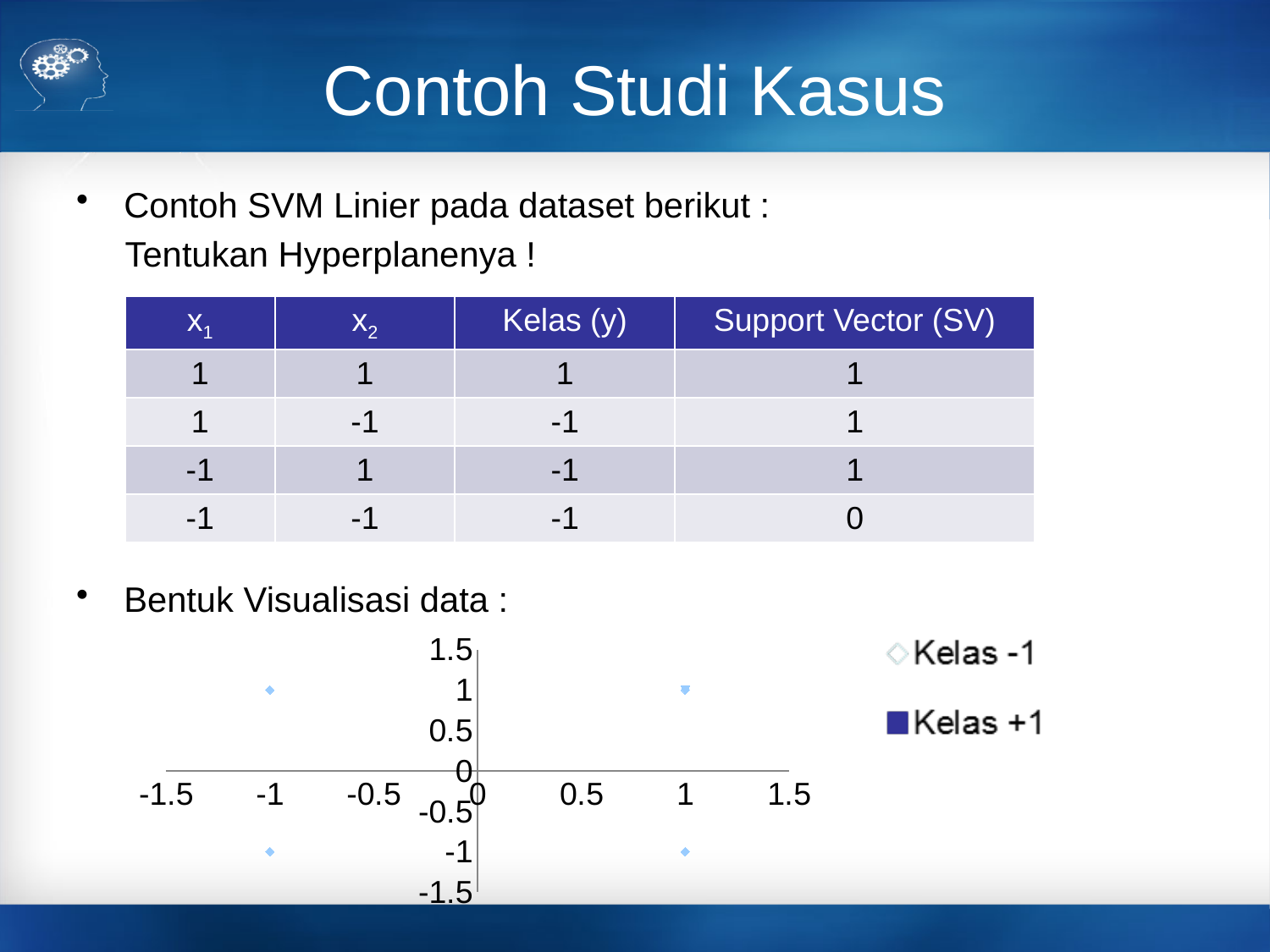
How many series does the legend of the scatter chart list? 2 In the scatter chart, is the y-coordinate of the point at x = -1 in the upper-left greater or less than 0.5? greater What are the two series named in the legend of the scatter chart? Kelas -1 and Kelas +1 In the scatter chart, what is the y-coordinate of the Kelas +1 point? 1 In the scatter chart, is the y-coordinate of the point at x = 1 in the lower-right greater or less than -0.5? less What is the lowest value shown on the horizontal axis of the scatter chart? -1.5 What is the highest value shown on the vertical axis of the scatter chart? 1.5 How many points in the scatter chart belong to the Kelas +1 series? 1 What kind of chart is shown under "Bentuk Visualisasi data"? scatter chart In the scatter chart, what is the x-coordinate of the Kelas +1 point? 1